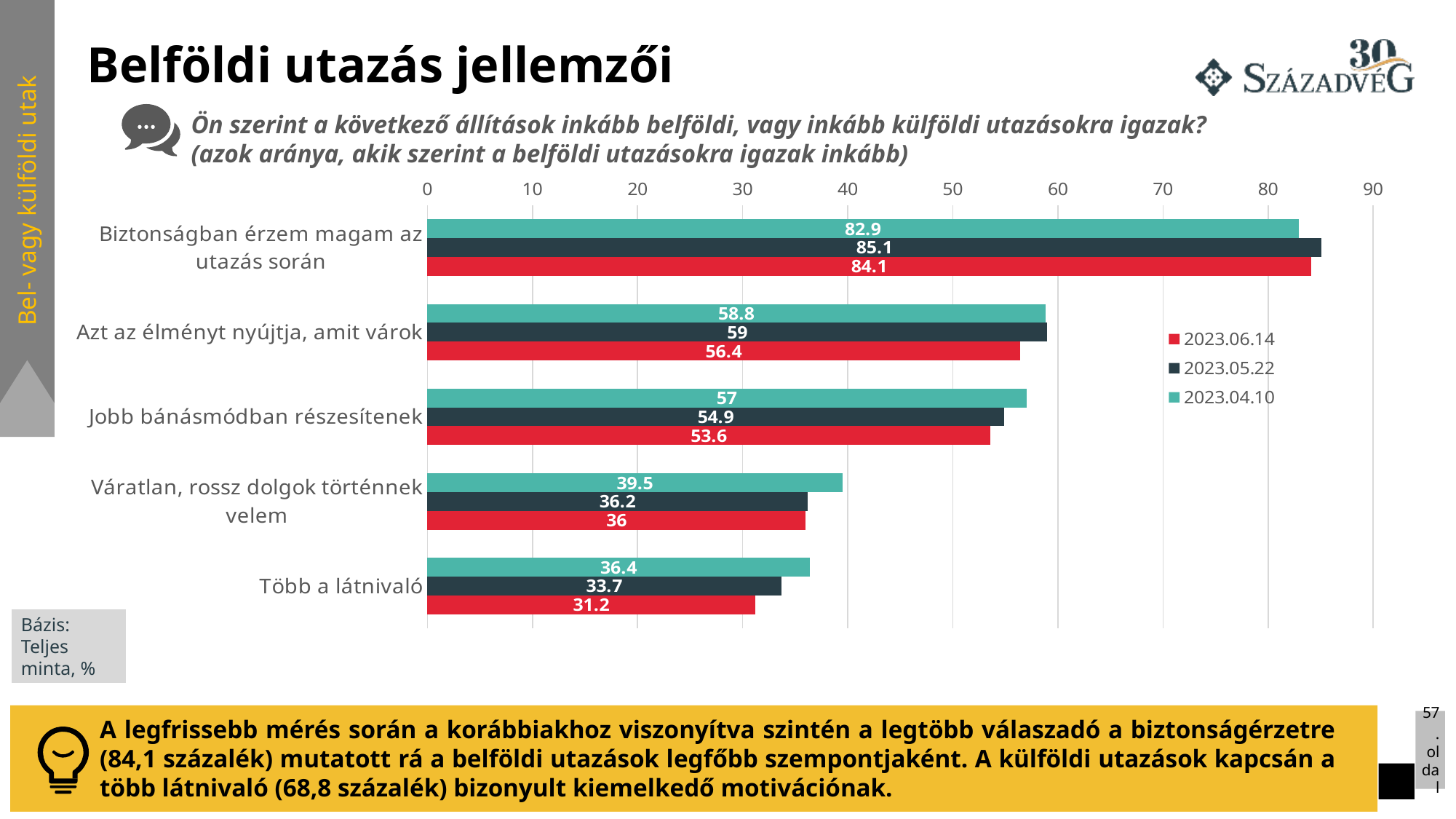
What is the value for "Biztonságban érzem magam az utazás során" in the 2023.06.14 series? 84.1 What kind of chart is shown on the slide? Bar chart How many categories are shown on the chart? 5 What is the value for "Több a látnivaló" in the 2023.04.10 series? 36.4 What is the difference between the 2023.05.22 and 2023.04.10 values for "Váratlan, rossz dolgok történnek velem"? 3.3 Which category has the highest value in the 2023.05.22 series? Biztonságban érzem magam az utazás során How many series does the legend list? 3 For "Azt az élményt nyújtja, amit várok", which series has the larger value: 2023.05.22 or 2023.06.14? 2023.05.22 Which category has the lowest value in the 2023.06.14 series? Több a látnivaló What is the difference between the 2023.04.10 and 2023.06.14 values for "Több a látnivaló"? 5.2 Which colour represents the 2023.06.14 series in the legend? Red What is the value for "Jobb bánásmódban részesítenek" in the 2023.05.22 series? 54.9